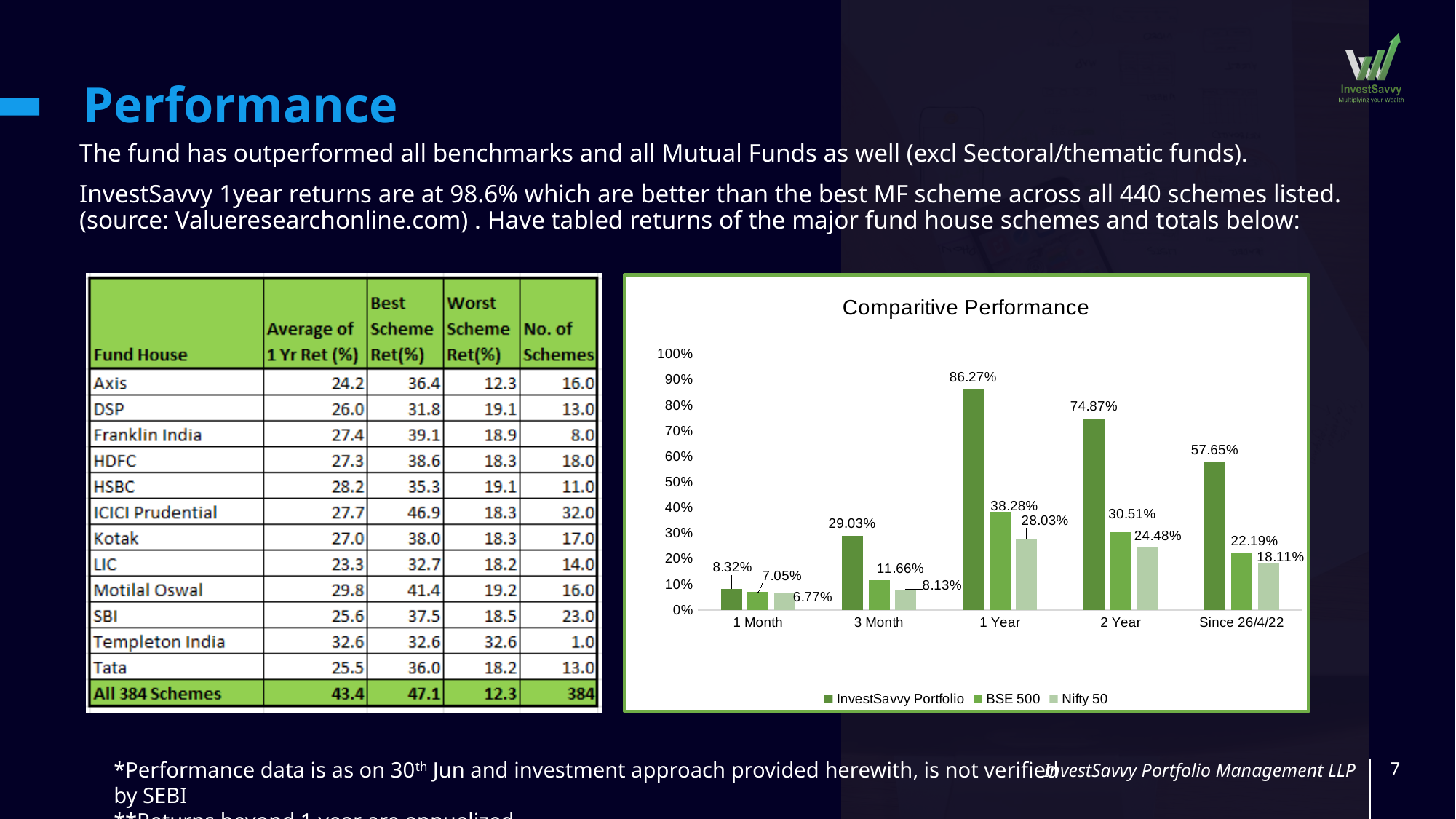
What is the InvestSavvy Portfolio value for Since 26/4/22? 57.65% What type of chart is shown on the slide? bar chart What is the Nifty 50 value for 3 Month? 8.13% Which is larger for 2 Year: BSE 500 or Nifty 50? BSE 500 What is the InvestSavvy Portfolio value for 1 Year? 86.27% In which period is the Nifty 50 value lowest? 1 Month What is the BSE 500 value for 2 Year? 30.51% How many series does the chart legend list? 3 What is the difference between the InvestSavvy Portfolio and BSE 500 values for 1 Year? 47.99% How many time-period categories are shown on the x axis of the chart? 5 In which period is the InvestSavvy Portfolio value highest? 1 Year What is the title of the chart? Comparitive Performance